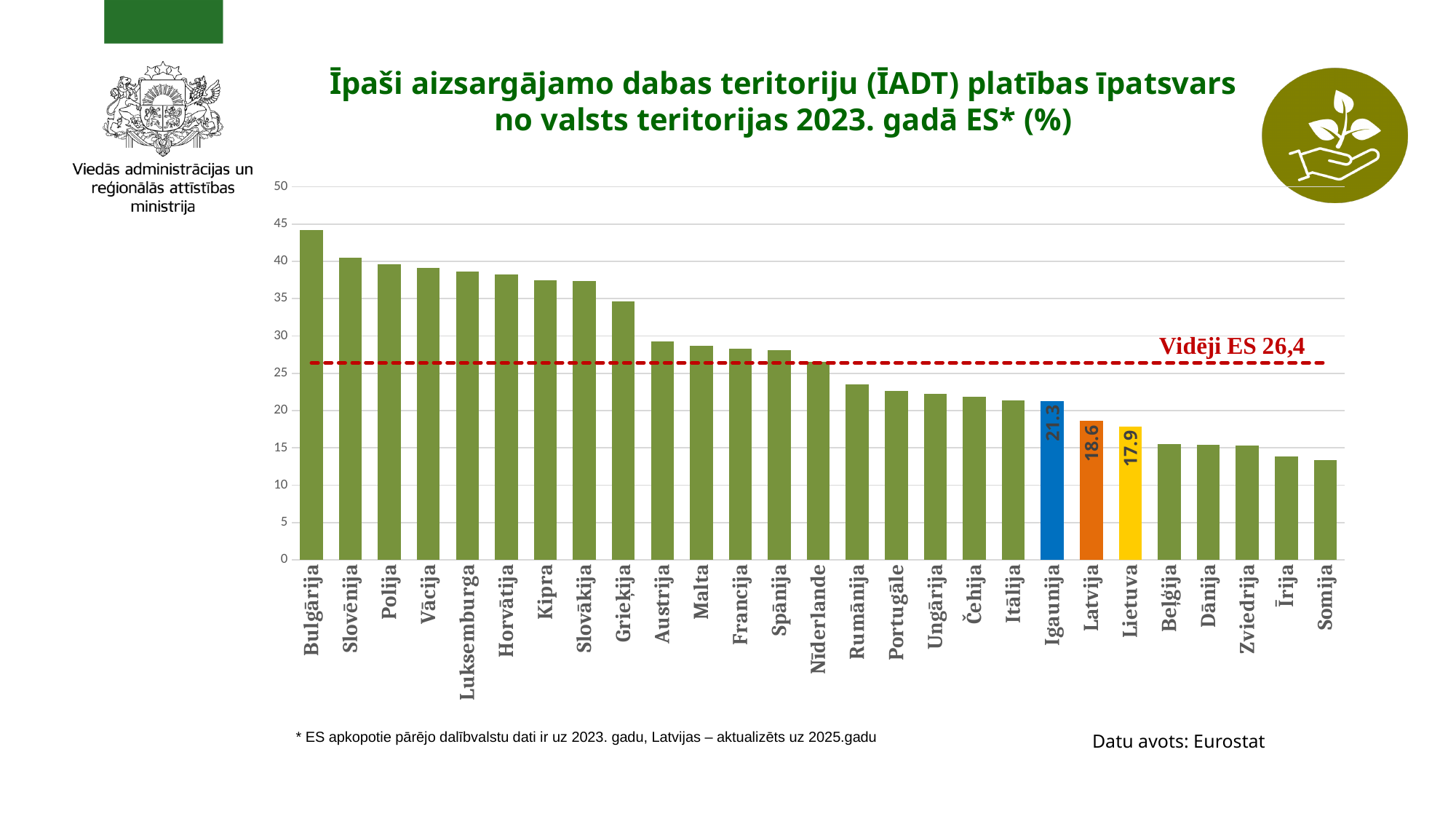
What is the value for Igaunija? 21.3 What is the difference between the values for Latvija and Lietuva? 0.7 Which is larger, the value for Latvija or the value for Lietuva? Latvija What is the value for Lietuva? 17.9 What is the difference between the values for Igaunija and Latvija? 2.7 What EU average value is marked by the dashed red line? 26,4 What kind of chart is shown on the slide? bar chart Is the value for Bulgārija greater or less than 40? greater How many countries are shown in the chart? 27 Which country has the highest value? Bulgārija What is the value for Latvija? 18.6 Is the value for Somija greater or less than 15? less